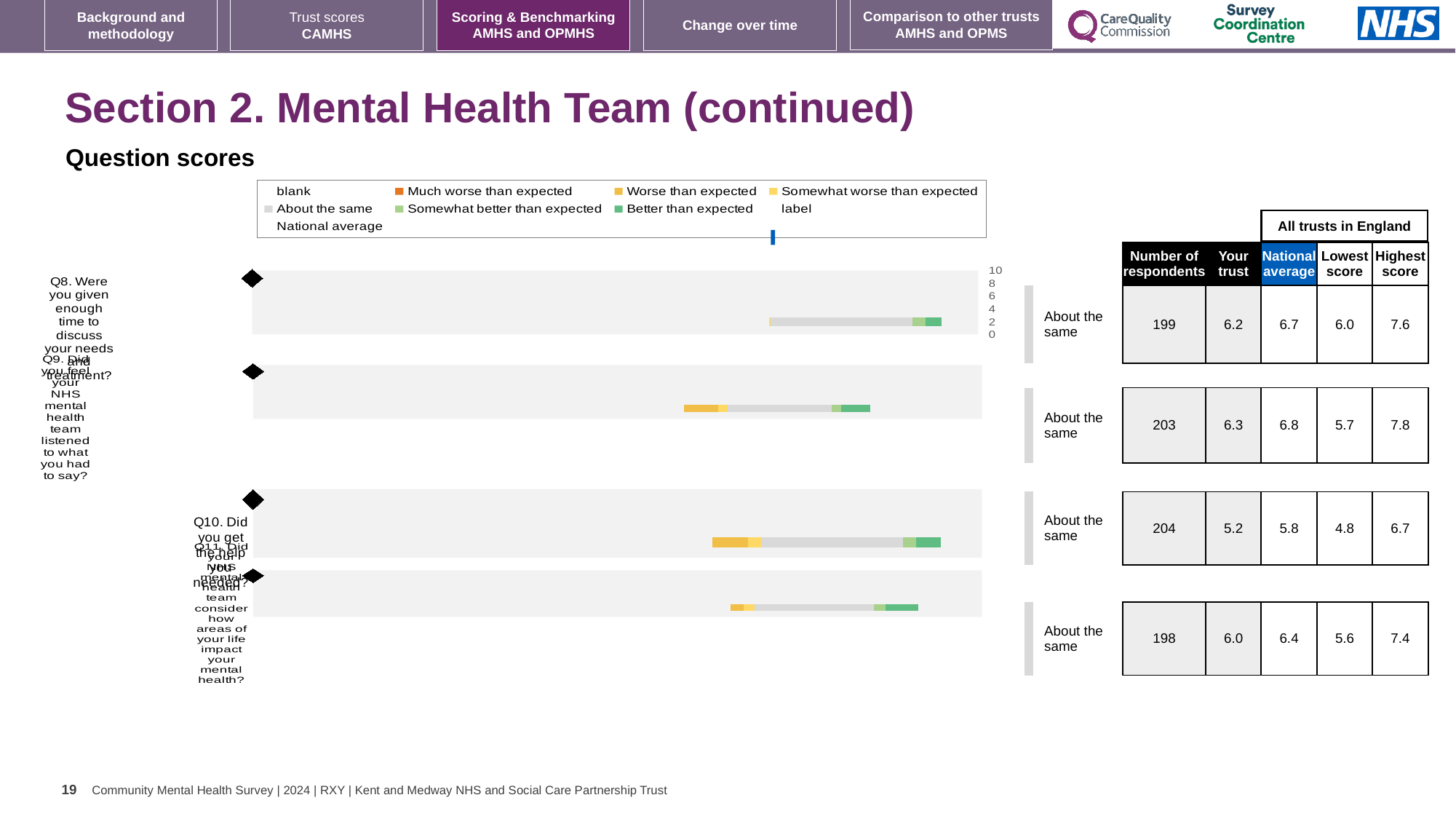
What is the highest tick value shown on the chart's score axis? 10 In the table beside the chart, what is the national average for Q10? 5.8 In the table beside the chart, what is the 'Your trust' score for Q9? 6.3 How many questions (categories) are plotted in the question scores chart? 4 Which legend entry is shown in orange in the question scores chart? Much worse than expected What kind of chart is used to show the question scores on this slide? bar chart In the table beside the chart, what is the highest score for Q11? 7.4 For Q8, what is the difference between the national average and the 'Your trust' score in the table beside the chart? 0.5 Which question has the highest 'Your trust' score in the table beside the chart? Q9 Which question has the lowest 'Your trust' score in the table beside the chart? Q10 In the table beside the chart, how many respondents answered Q8? 199 For Q11, which is larger in the table beside the chart: the 'Your trust' score or the national average? National average